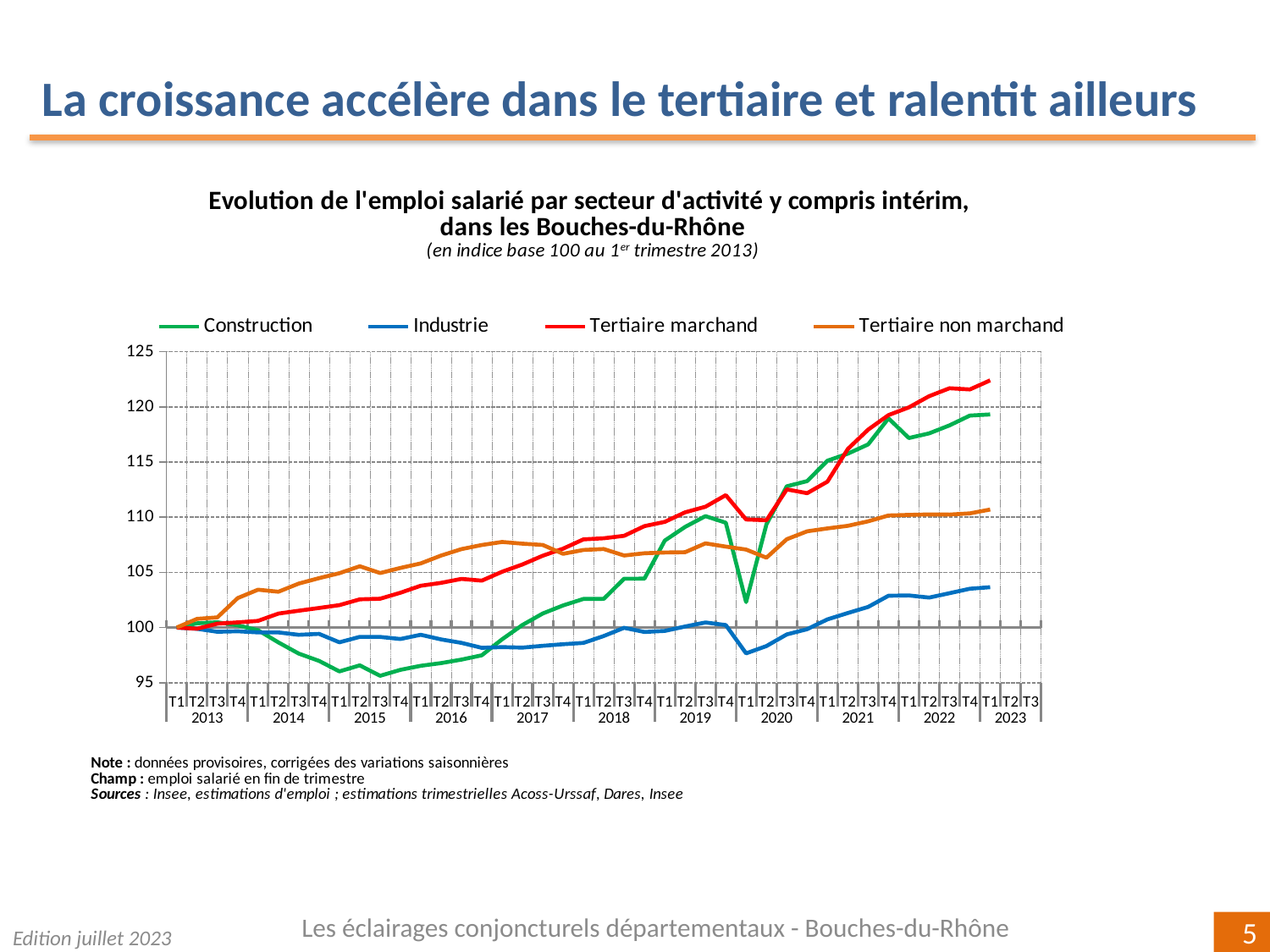
At T1 2016, which is larger: Tertiaire non marchand or Construction? Tertiaire non marchand Is the value for Industrie at T1 2023 greater or less than 105? less Which series has the highest value at T1 2023? Tertiaire marchand What is the title of the chart? Evolution de l'emploi salarié par secteur d'activité y compris intérim, dans les Bouches-du-Rhône Does the Tertiaire non marchand series rise or fall overall from T1 2013 to T1 2023? rise Is the value for Tertiaire marchand at T1 2023 greater or less than 120? greater What is the index value of each series at T1 2013? 100 Is the value for Construction at T3 2015 greater or less than 100? less What are the four series listed in the legend? Construction, Industrie, Tertiaire marchand, Tertiaire non marchand How many series does the legend list? 4 Which series has the lowest value at T1 2023? Industrie What kind of chart is shown on the slide? line chart